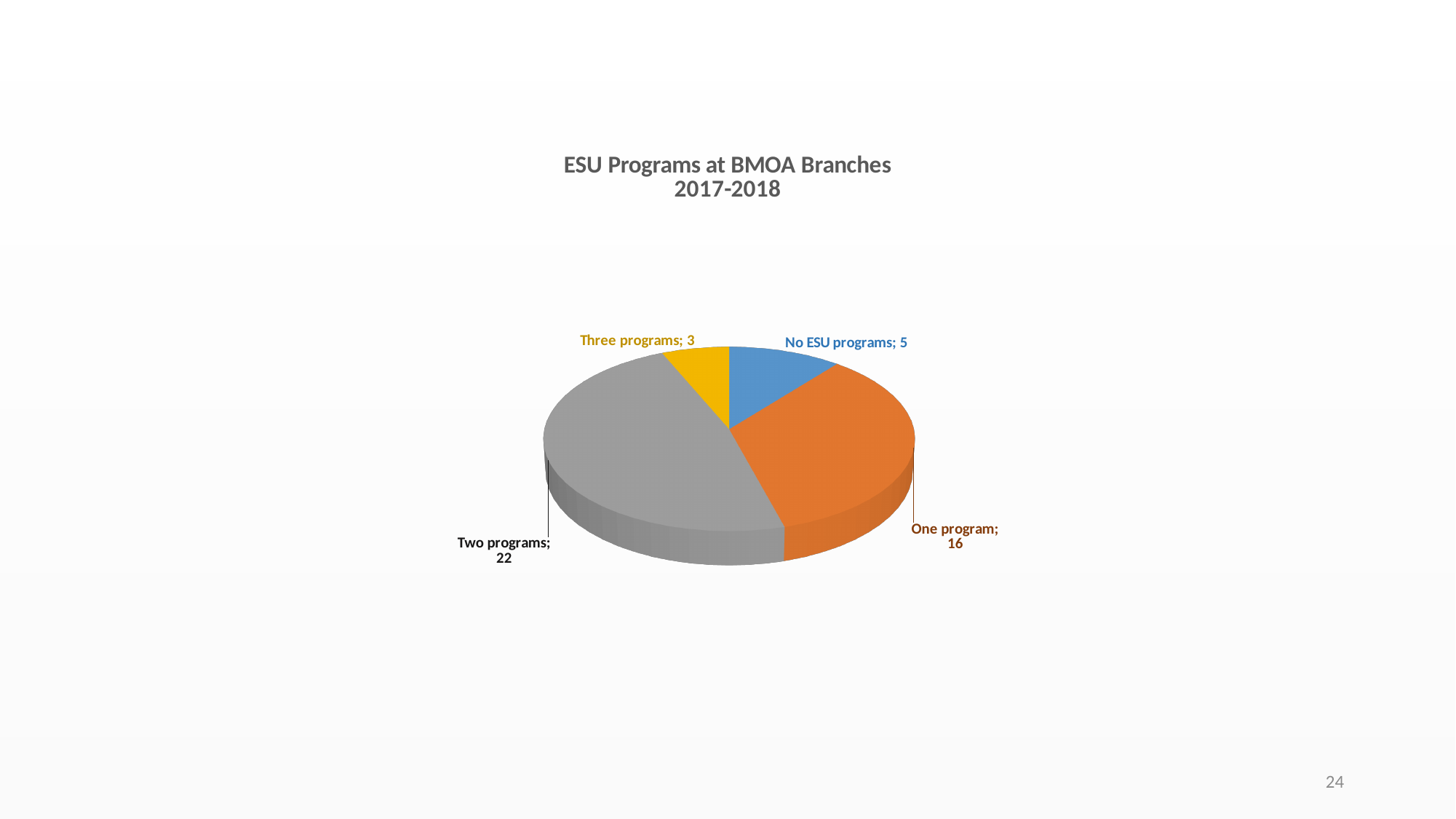
Which category has the smallest slice? Three programs What is the total of all slices in the pie chart? 46 How many slices does the pie chart have? 4 What is the difference between the values for Two programs and One program? 6 Which category has the largest slice? Two programs What is the value for No ESU programs? 5 What is the value for Three programs? 3 Which is larger, the value for No ESU programs or the value for Three programs? No ESU programs What kind of chart is shown on the slide? pie chart What is the value for One program? 16 What is the title of the chart? ESU Programs at BMOA Branches 2017-2018 How many branches had two programs? 22